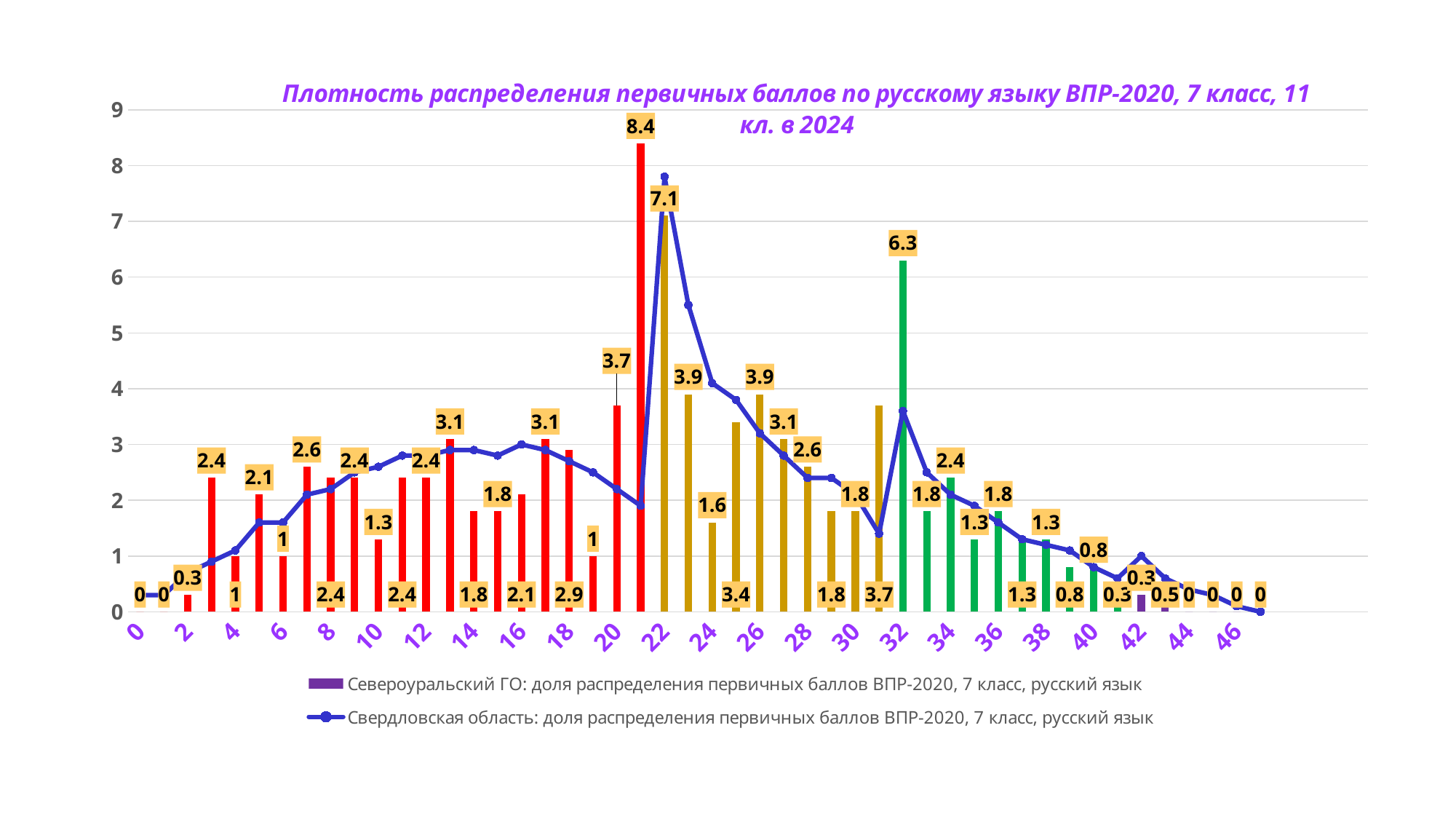
How many series does the legend list? 2 Which primary score has the highest Североуральский ГО bar? 21 Is the Свердловская область line value at score 22 greater or less than 7? greater What is the value of the Североуральский ГО bar for a primary score of 43? 0.5 What is the difference between the Североуральский ГО bars for scores 21 and 22? 1.3 What kind of chart is shown on the slide? Combined bar and line chart What is the value of the Североуральский ГО bar for a primary score of 21? 8.4 What is the value of the Североуральский ГО bar for a primary score of 10? 1.3 Which is larger for Североуральский ГО: the bar for score 20 or the bar for score 32? score 32 Is the Свердловская область line value at score 40 greater or less than 1? less What is the value of the Североуральский ГО bar for a primary score of 32? 6.3 Which series is drawn as a line with markers according to the legend? Свердловская область: доля распределения первичных баллов ВПР-2020, 7 класс, русский язык